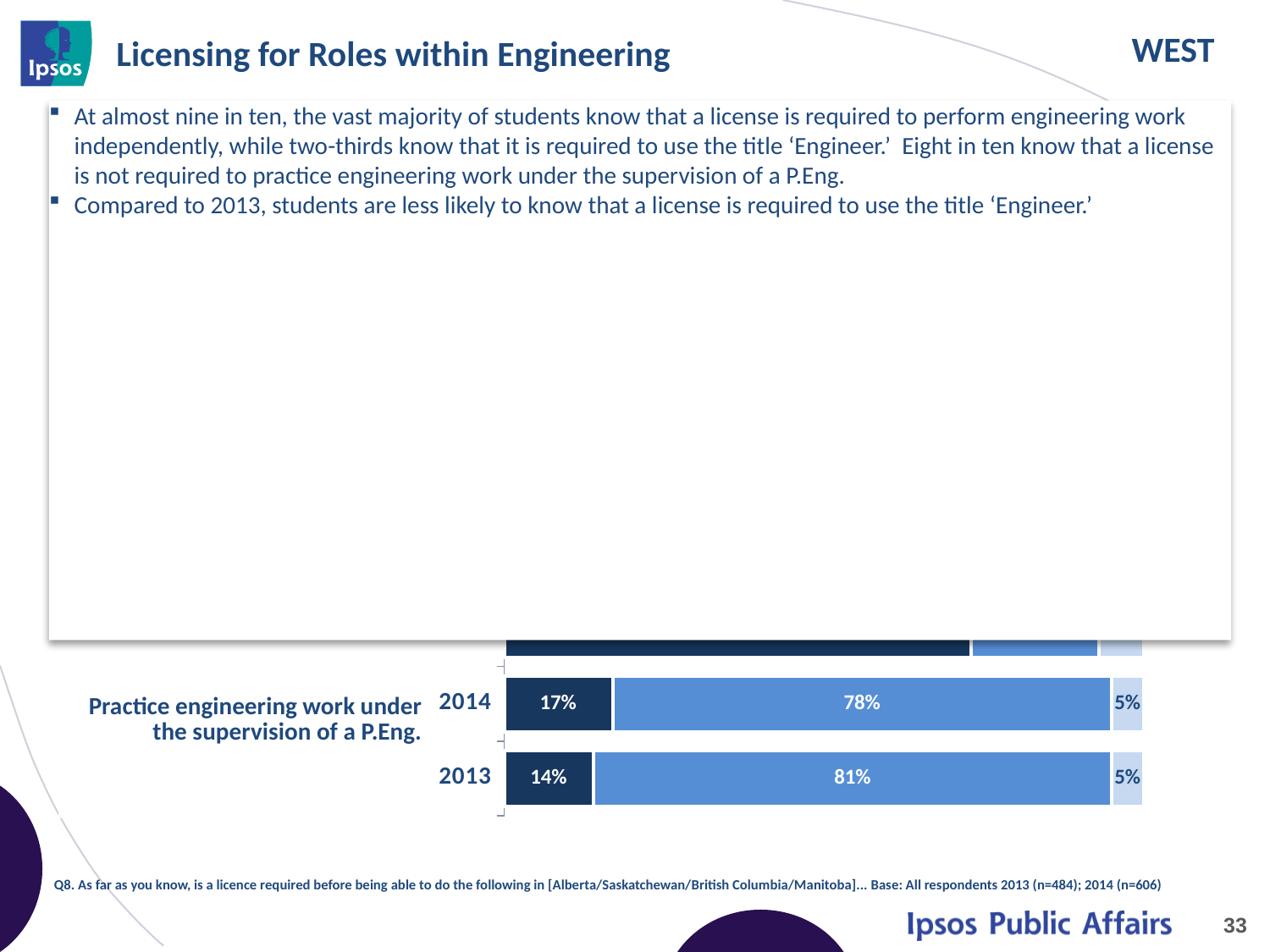
For 'Practice engineering work under the supervision of a P.Eng.' in 2013, what is the value of the light blue (last) segment? 5% Which two years are compared in the visible bars of the chart? 2014 and 2013 What is the total of the three segments in the 2014 bar for 'Practice engineering work under the supervision of a P.Eng.'? 100% What is the difference between the medium blue segment values for 2013 and 2014 under 'Practice engineering work under the supervision of a P.Eng.'? 3% What type of chart is shown on the slide? stacked bar chart For 'Practice engineering work under the supervision of a P.Eng.' in 2014, what is the value of the medium blue (middle) segment? 78% For 'Practice engineering work under the supervision of a P.Eng.' in 2013, what is the value of the medium blue (middle) segment? 81% Which year has the larger medium blue segment for 'Practice engineering work under the supervision of a P.Eng.', 2013 or 2014? 2013 For 'Practice engineering work under the supervision of a P.Eng.' in 2013, what is the value of the dark blue (first) segment? 14% For 'Practice engineering work under the supervision of a P.Eng.' in 2014, what is the value of the dark blue (first) segment? 17% What is the difference between the dark blue segment values for 2014 and 2013 under 'Practice engineering work under the supervision of a P.Eng.'? 3% Which year has the larger dark blue segment for 'Practice engineering work under the supervision of a P.Eng.', 2013 or 2014? 2014